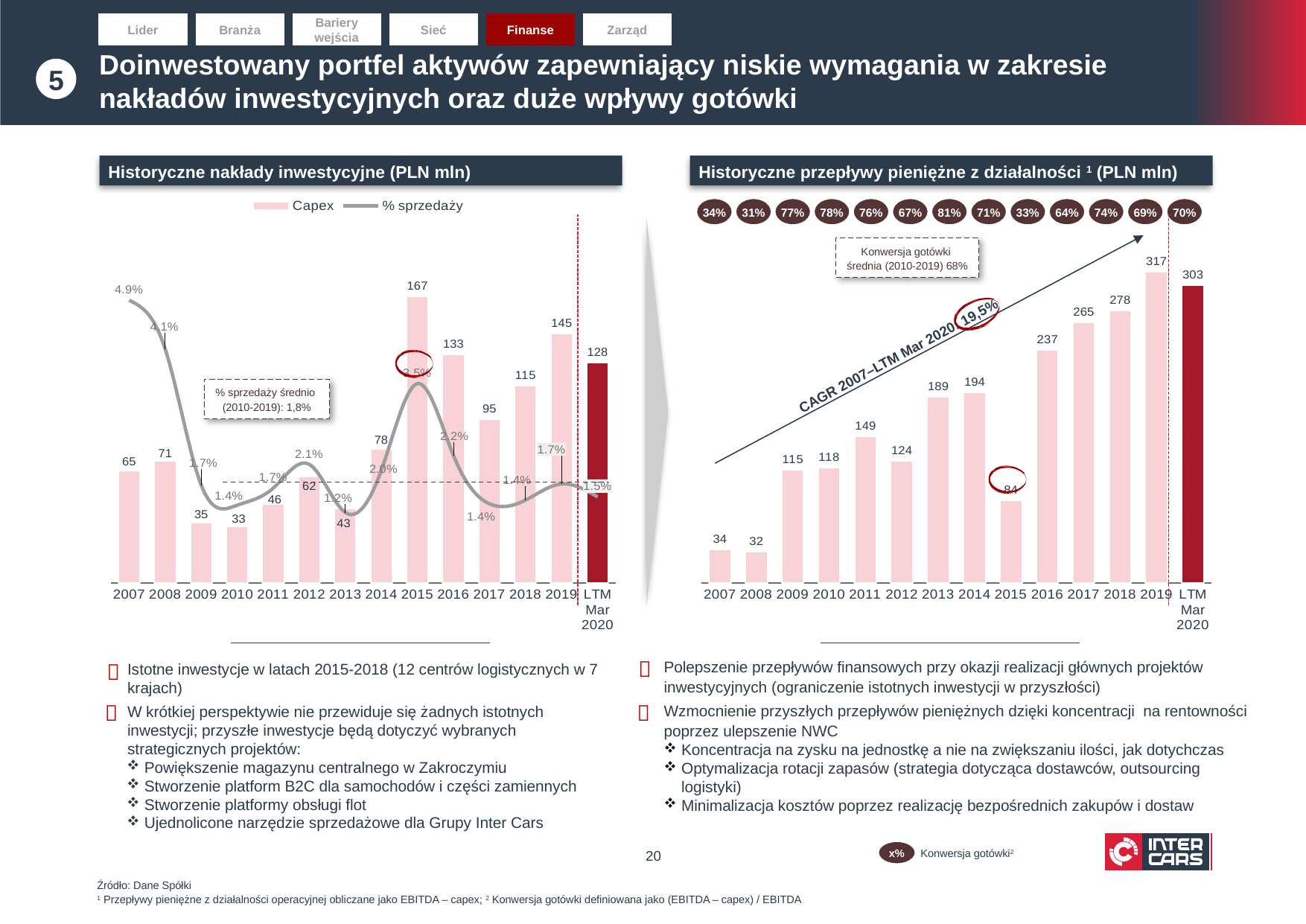
In the chart 'Historyczne przepływy pieniężne z działalności (PLN mln)', which year has the highest value? 2019 In the chart 'Historyczne przepływy pieniężne z działalności (PLN mln)', what is the value for 2015? 84 In the chart 'Historyczne nakłady inwestycyjne (PLN mln)', what is the Capex value for 2015? 167 What type of chart is 'Historyczne przepływy pieniężne z działalności (PLN mln)'? Bar chart In the chart 'Historyczne nakłady inwestycyjne (PLN mln)', what is the Capex value for LTM Mar 2020? 128 How many categories are shown on the x axis of the chart 'Historyczne przepływy pieniężne z działalności (PLN mln)'? 14 In the chart 'Historyczne nakłady inwestycyjne (PLN mln)', what is the '% sprzedaży' value for 2007? 4.9% In the chart 'Historyczne przepływy pieniężne z działalności (PLN mln)', what is the difference between the value for 2019 and the value for LTM Mar 2020? 14 In the chart 'Historyczne przepływy pieniężne z działalności (PLN mln)', which is larger: the value for 2013 or the value for 2014? 2014 How many series does the legend of the chart 'Historyczne nakłady inwestycyjne (PLN mln)' list? 2 In the chart 'Historyczne nakłady inwestycyjne (PLN mln)', what is the difference between the Capex for 2019 and the Capex for 2018? 30 In the chart 'Historyczne nakłady inwestycyjne (PLN mln)', which year has the lowest Capex? 2010